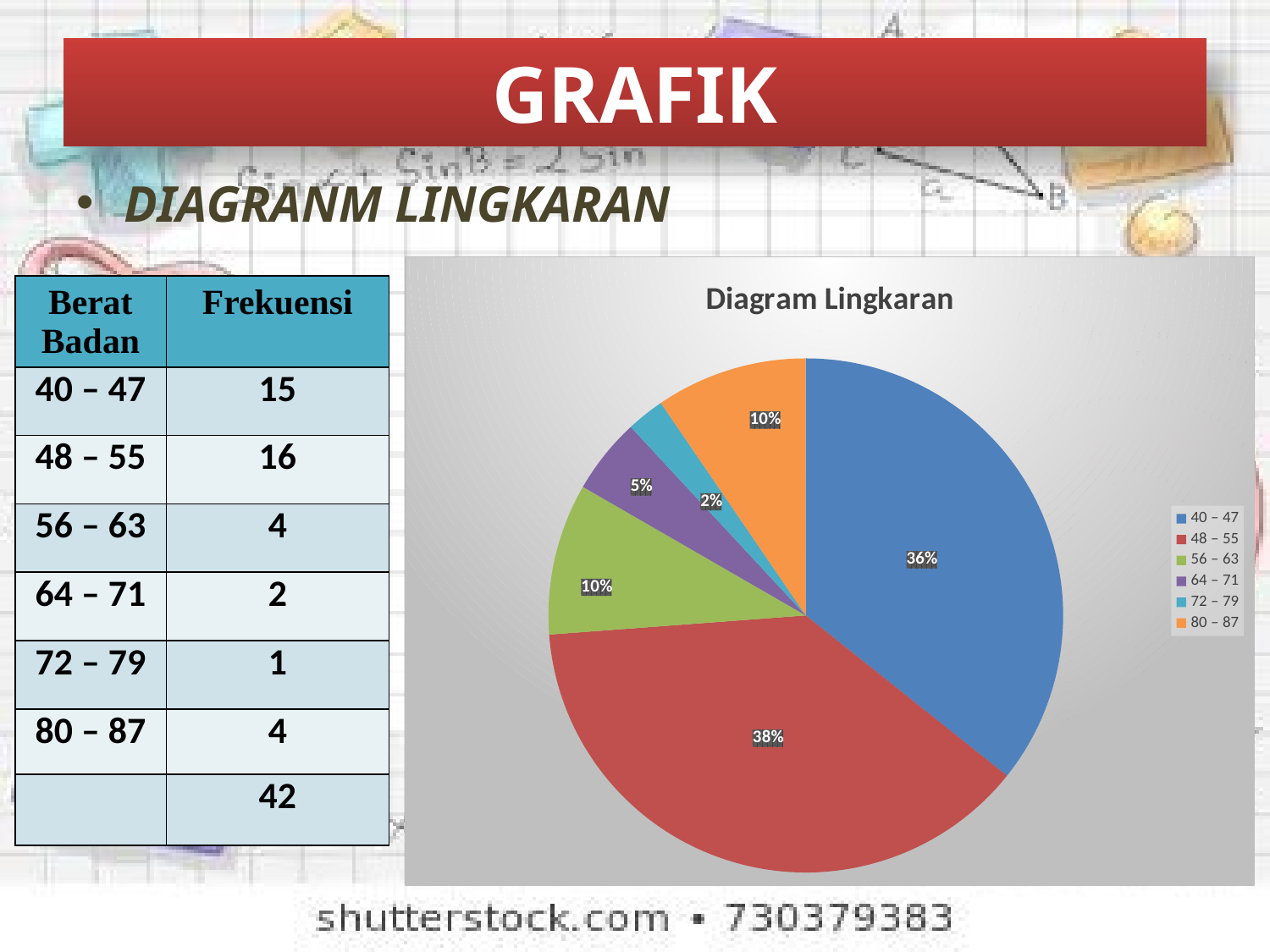
What is the title of the chart? Diagram Lingkaran Which slice is larger: 56 – 63 or 64 – 71? 56 – 63 Which category has the smallest slice of the pie? 72 – 79 What percentage is shown for the 72 – 79 slice? 2% What percentage is shown for the 48 – 55 slice? 38% What colour is the 48 – 55 slice in the pie chart? Red What is the difference in percentage points between the 48 – 55 slice and the 40 – 47 slice? 2 What percentage is shown for the 64 – 71 slice? 5% How many slices does the pie chart have? 6 What type of chart is shown on the slide? Pie chart What percentage is shown for the 40 – 47 slice? 36% Which category has the largest slice of the pie? 48 – 55